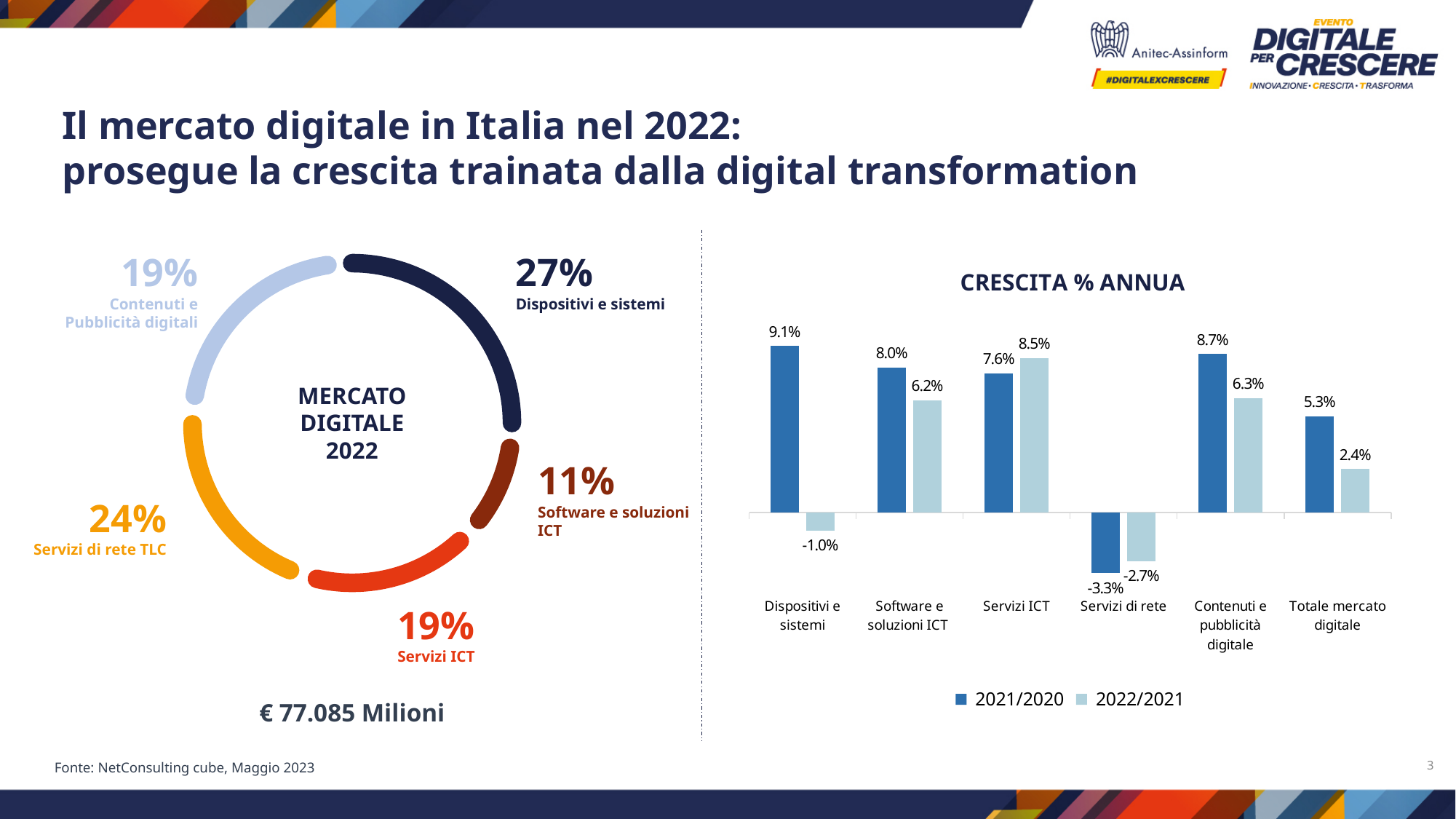
In the CRESCITA % ANNUA chart, what is the 2022/2021 value for Totale mercato digitale? 2.4% In the CRESCITA % ANNUA chart, what is the 2022/2021 value for Servizi ICT? 8.5% How many categories are shown on the x axis of the CRESCITA % ANNUA chart? 6 In the CRESCITA % ANNUA chart, what is the 2021/2020 value for Dispositivi e sistemi? 9.1% What kind of chart is the CRESCITA % ANNUA chart? bar chart In the CRESCITA % ANNUA chart, is the 2022/2021 value for Software e soluzioni ICT larger or smaller than its 2021/2020 value? smaller In the MERCATO DIGITALE 2022 chart, which segment has the largest share? Dispositivi e sistemi In the CRESCITA % ANNUA chart, which category has the highest 2021/2020 value? Dispositivi e sistemi In the CRESCITA % ANNUA chart, what is the difference between the 2021/2020 and 2022/2021 values for Contenuti e pubblicità digitale? 2.4% In the MERCATO DIGITALE 2022 chart, what share does Servizi di rete TLC have? 24% In the CRESCITA % ANNUA chart, which category has the lowest 2022/2021 value? Servizi di rete How many series does the legend of the CRESCITA % ANNUA chart list? 2